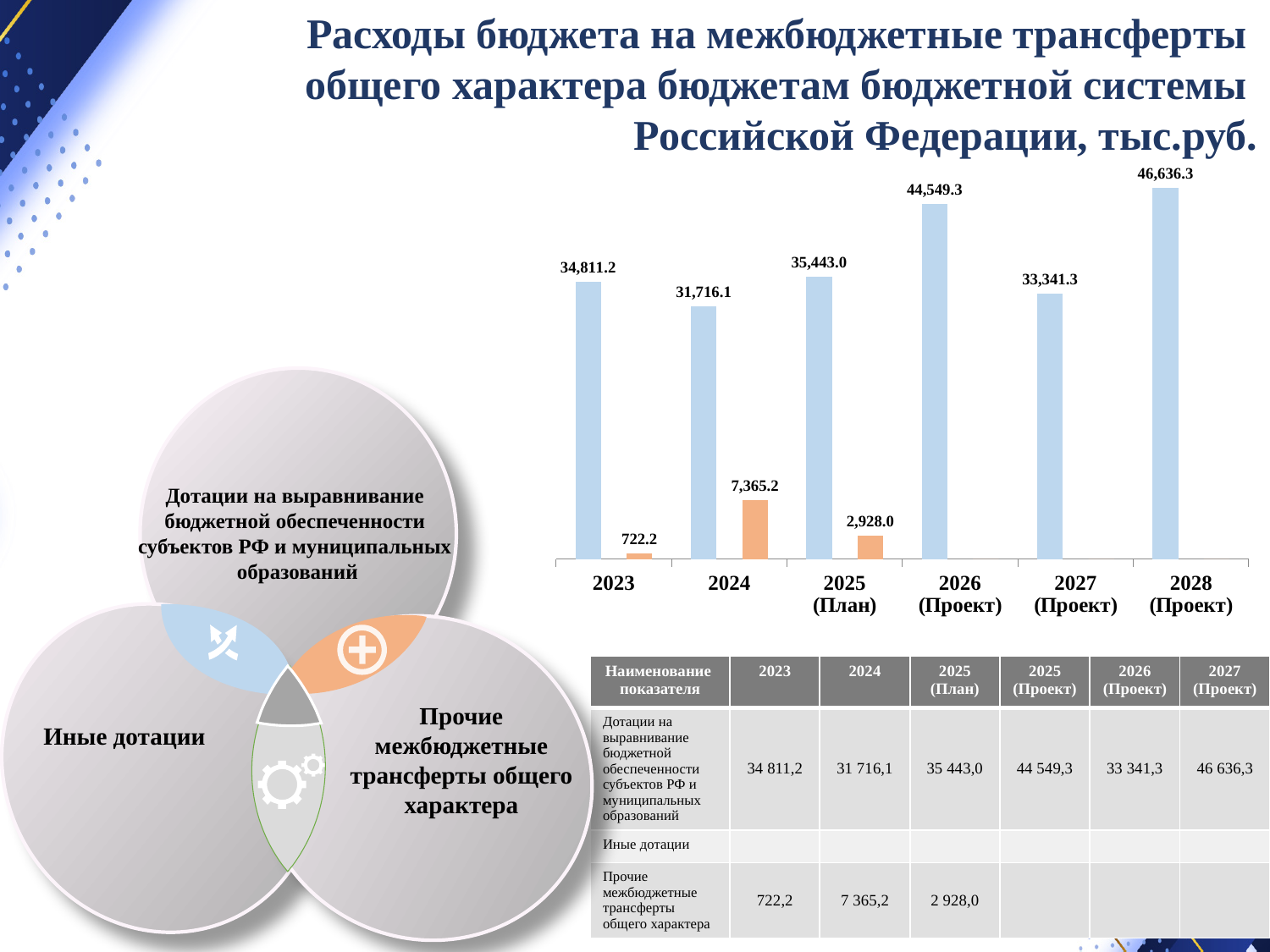
What is the value of the blue bar for 2026 (Проект)? 44,549.3 Which year has the highest orange bar? 2024 Which year has the lowest blue bar? 2024 How many year categories are shown on the x axis of the chart? 6 How many years have an orange bar in the chart? 3 What is the value of the orange bar for 2024? 7,365.2 What is the difference between the orange bar values for 2024 and 2025 (План)? 4,437.2 What type of chart is shown on the slide? bar chart What is the difference between the blue bar values for 2028 (Проект) and 2027 (Проект)? 13,295.0 What is the value of the orange bar for 2023? 722.2 Which year has the highest blue bar? 2028 (Проект) Which is larger, the blue bar for 2025 (План) or the blue bar for 2023? 2025 (План)